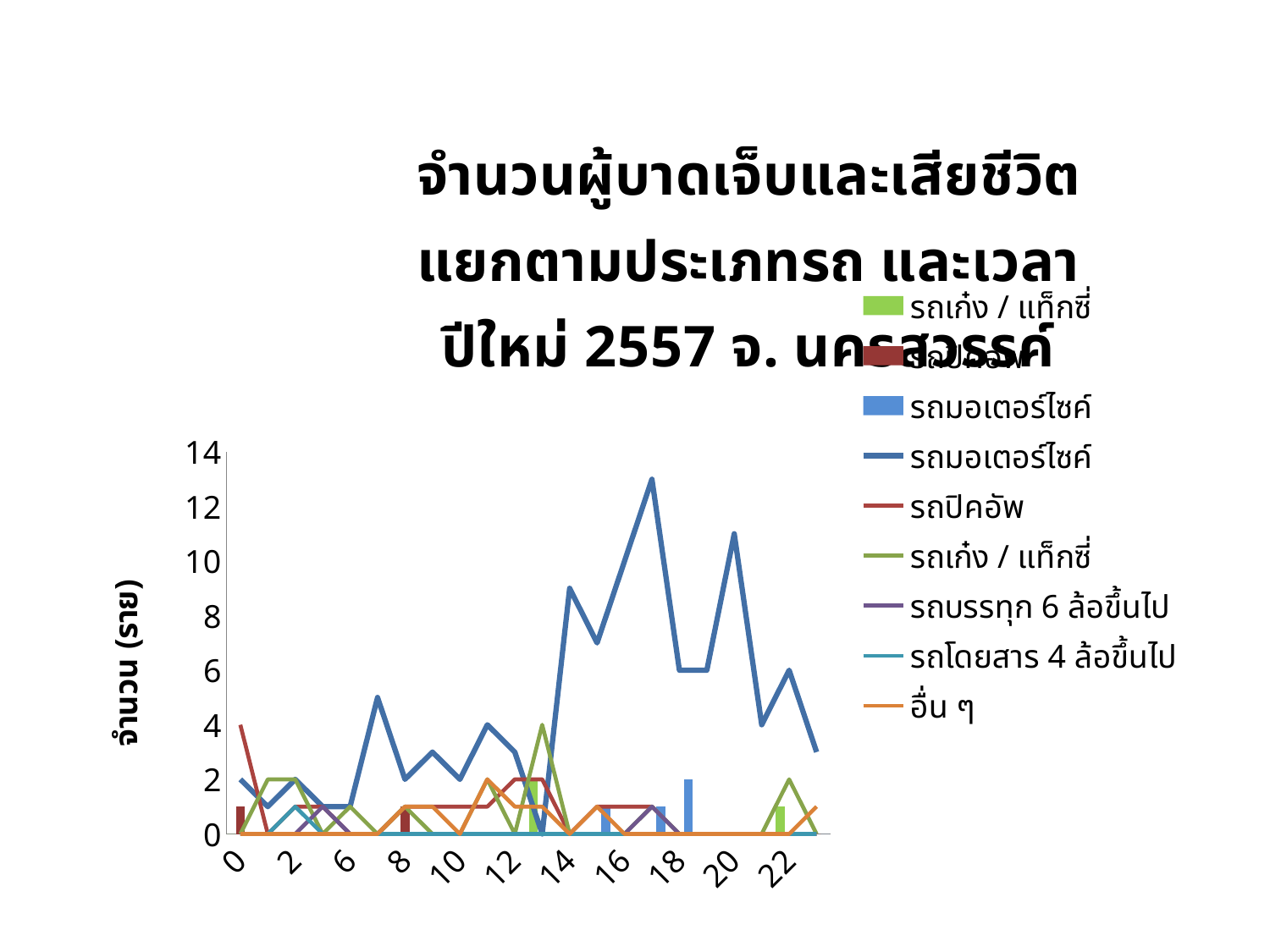
What kind of chart is shown on the slide? A combined line and bar chart At which hour does the รถมอเตอร์ไซค์ line reach its highest value? 17 Is the value of the รถมอเตอร์ไซค์ line at hour 19 greater or less than 10? less Is the value of the รถมอเตอร์ไซค์ line at hour 17 greater or less than 12? greater What is the value of the รถมอเตอร์ไซค์ line at hour 0? 2 What is the highest tick value shown on the vertical axis? 14 Which is larger: the รถมอเตอร์ไซค์ line at hour 17 or at hour 19? hour 17 How many series does the legend list? 9 What is the label on the vertical axis? จำนวน (ราย) What is the value of the รถมอเตอร์ไซค์ line at hour 18? 6 Which series reaches the highest value on the chart? รถมอเตอร์ไซค์